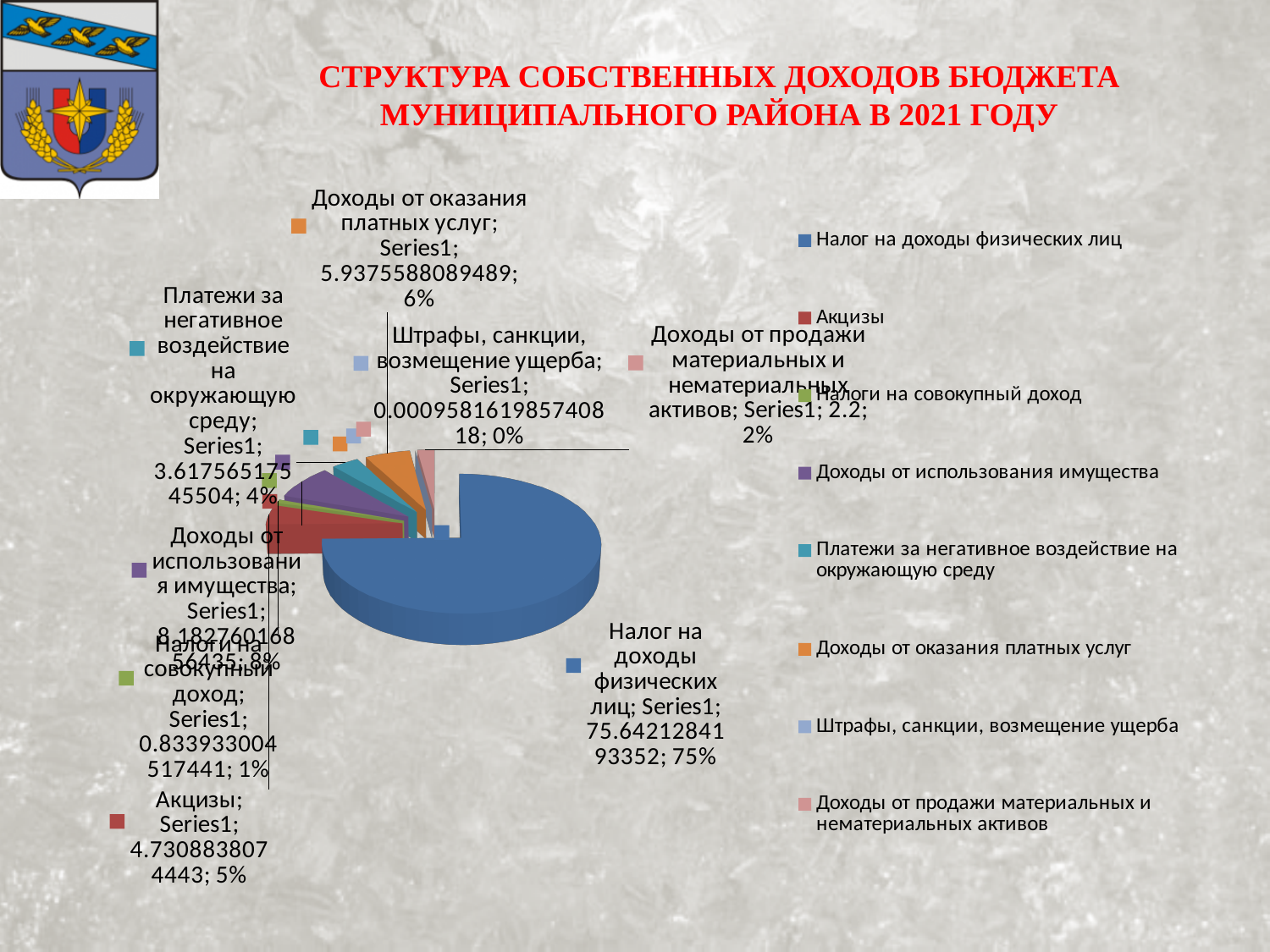
What percentage is shown for "Доходы от оказания платных услуг"? 6% What kind of chart is shown on the slide? pie chart How many slices does the pie chart have? 8 What is the title of the chart on the slide? СТРУКТУРА СОБСТВЕННЫХ ДОХОДОВ БЮДЖЕТА МУНИЦИПАЛЬНОГО РАЙОНА В 2021 ГОДУ What percentage is shown for "Акцизы"? 5% Which category has the smallest share, labelled 0%? Штрафы, санкции, возмещение ущерба How many entries does the legend list? 8 What percentage is shown for "Доходы от использования имущества"? 8% Which is larger: the share for "Акцизы" or the share for "Доходы от продажи материальных и нематериальных активов"? Акцизы What percentage is shown for "Платежи за негативное воздействие на окружающую среду"? 4% Which category has the largest slice of the pie? Налог на доходы физических лиц What share of the pie does "Налог на доходы физических лиц" take? 75%